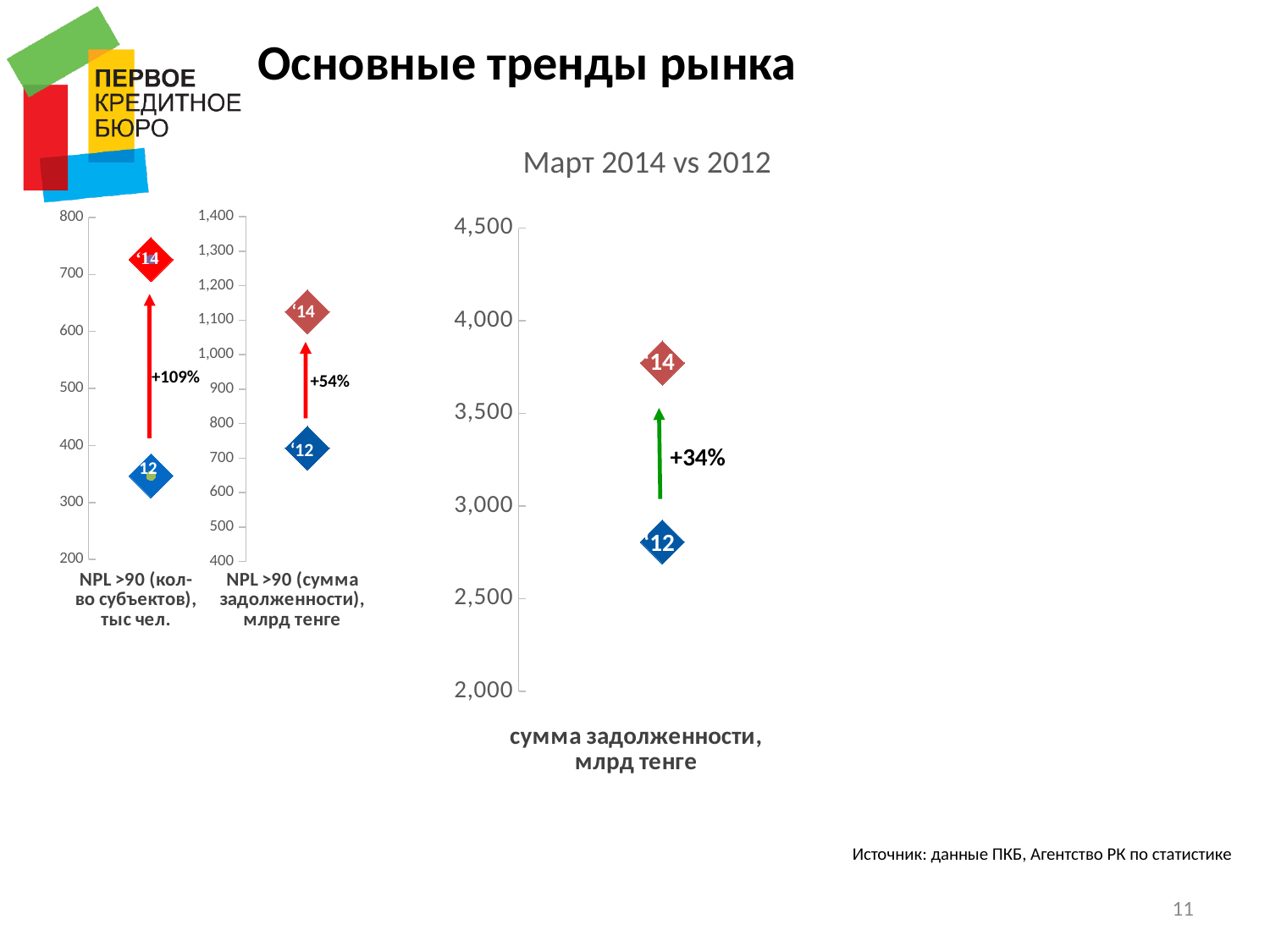
On the chart titled 'сумма задолженности, млрд тенге', is the value for '12 greater or less than 3,000? less On the chart titled 'NPL >90 (сумма задолженности), млрд тенге', is the value for '12 greater or less than 800? less On the chart titled 'NPL >90 (сумма задолженности), млрд тенге', is the value for '14 greater or less than 1,000? greater On the chart titled 'NPL >90 (кол-во субъектов), тыс чел.', what percentage change is printed between the '12 and '14 points? +109% On the chart titled 'сумма задолженности, млрд тенге', which point is higher, '12 or '14? '14 On the chart titled 'сумма задолженности, млрд тенге', what percentage change is printed between the '12 and '14 points? +34% On the chart titled 'NPL >90 (сумма задолженности), млрд тенге', what percentage change is printed between the '12 and '14 points? +54% What comparison period is stated in the subtitle above the charts? Март 2014 vs 2012 How many data points are plotted on the chart titled 'NPL >90 (кол-во субъектов), тыс чел.'? 2